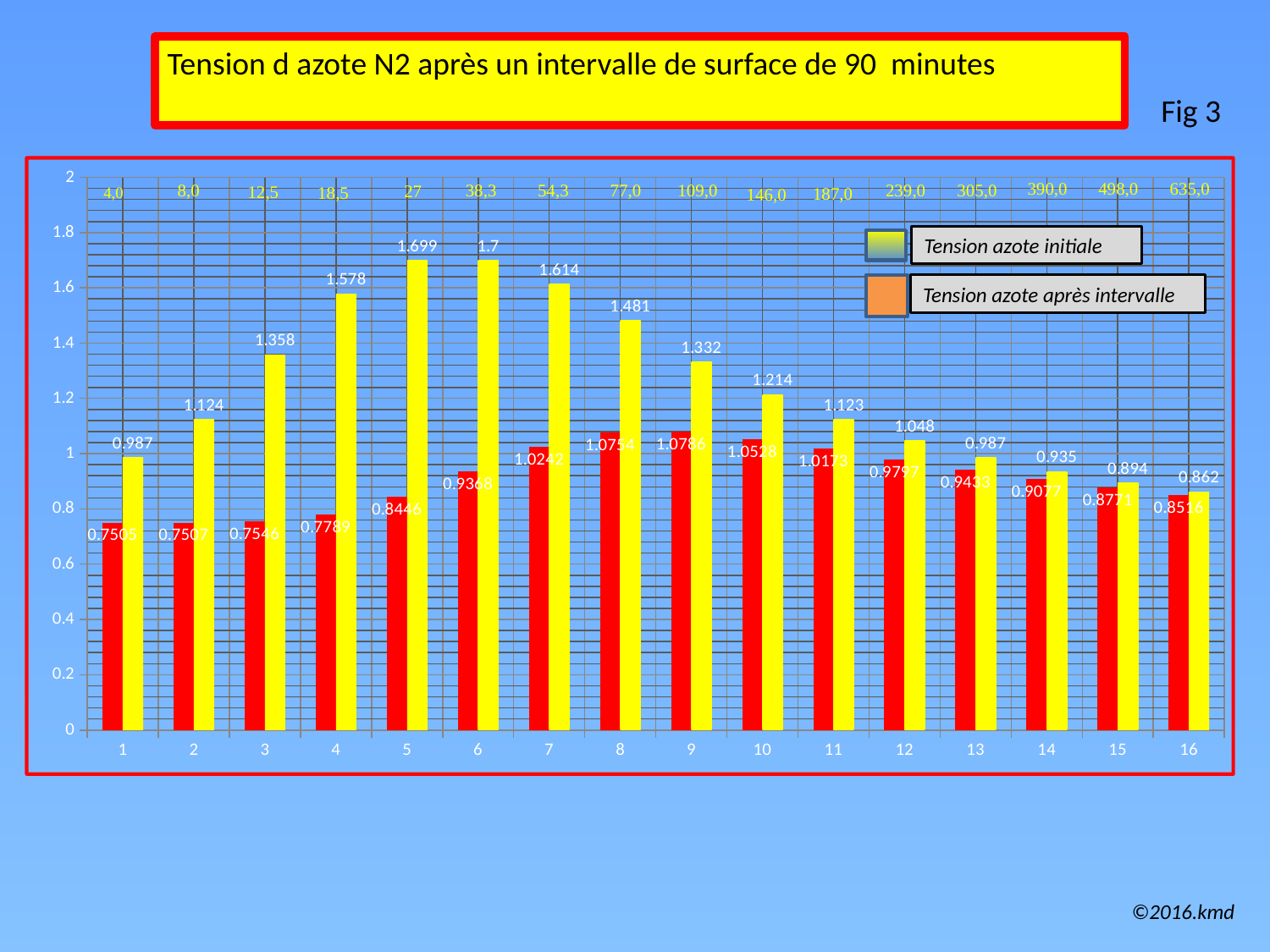
How many series does the legend list? 2 For category 13, which is larger: Tension azote initiale or Tension azote après intervalle? Tension azote initiale Do the values of Tension azote initiale rise or fall from category 6 to category 16? fall What is the value of Tension azote après intervalle for category 1? 0.7505 How many categories are shown on the x axis? 16 Which category has the lowest value of Tension azote initiale? 16 What is the difference between Tension azote initiale and Tension azote après intervalle for category 4? 0.7991 What kind of chart is shown on the slide? bar chart Is the value of Tension azote initiale for category 3 greater or less than 1.2? greater Which category has the highest value of Tension azote initiale? 6 What is the value of Tension azote après intervalle for category 9? 1.0786 What is the value of Tension azote initiale for category 5? 1.699